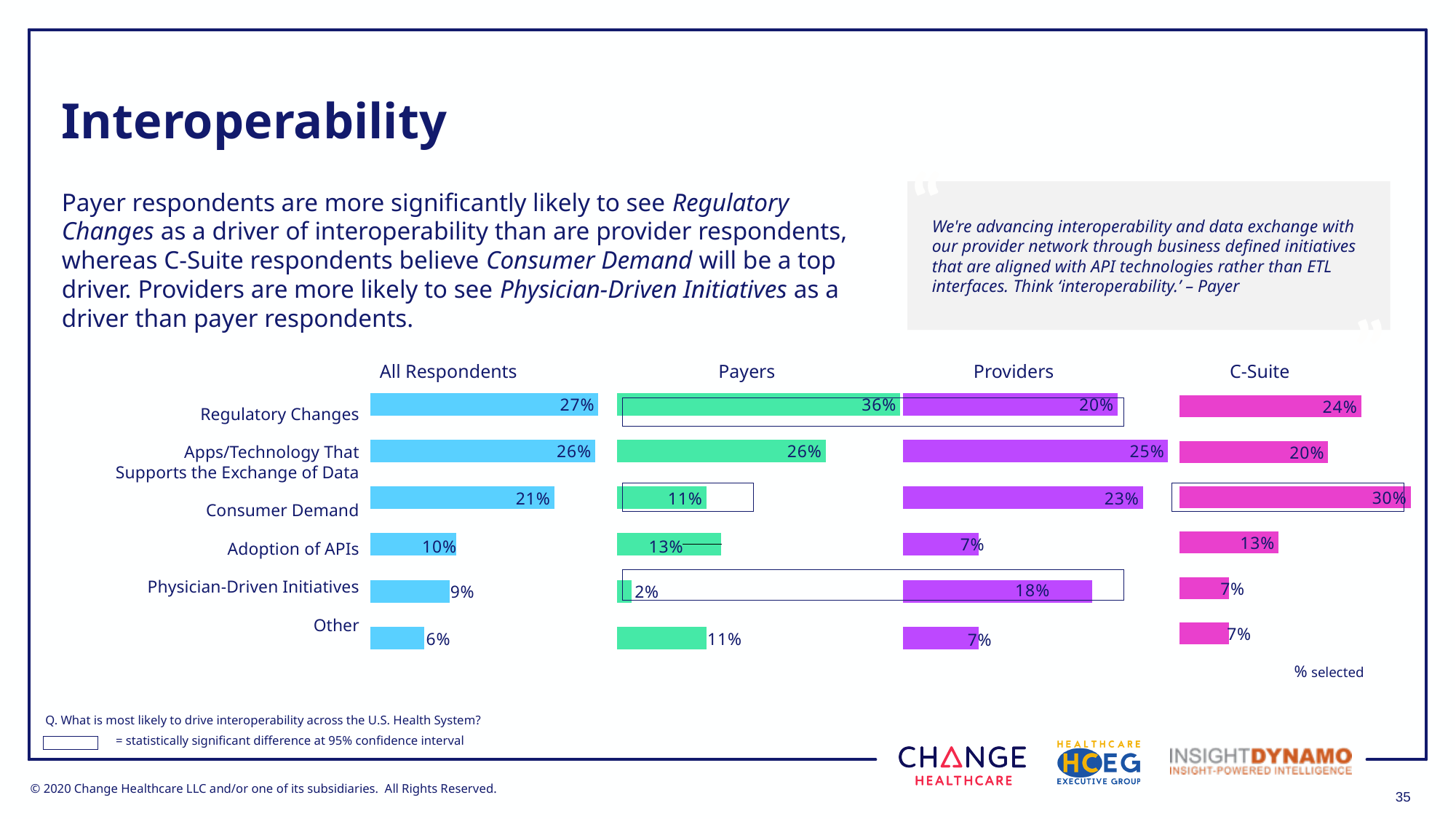
For Consumer Demand, which is larger: the Payers value or the Providers value? Providers What is the difference between the All Respondents values for Adoption of APIs and Other? 4% In the Providers chart, what percentage selected Physician-Driven Initiatives? 18% What type of chart is used to show the All Respondents data? Bar chart How many categories are shown in the All Respondents chart? 6 In the Payers chart, which category has the lowest value? Physician-Driven Initiatives What is the difference between the Payers and Providers values for Regulatory Changes? 16% In the Payers chart, what percentage selected Regulatory Changes? 36% In the C-Suite chart, what percentage selected Consumer Demand? 30% In the Providers chart, which category has the highest value? Apps/Technology That Supports the Exchange of Data In the C-Suite chart, which category has the highest value? Consumer Demand In the All Respondents chart, what percentage selected Regulatory Changes? 27%